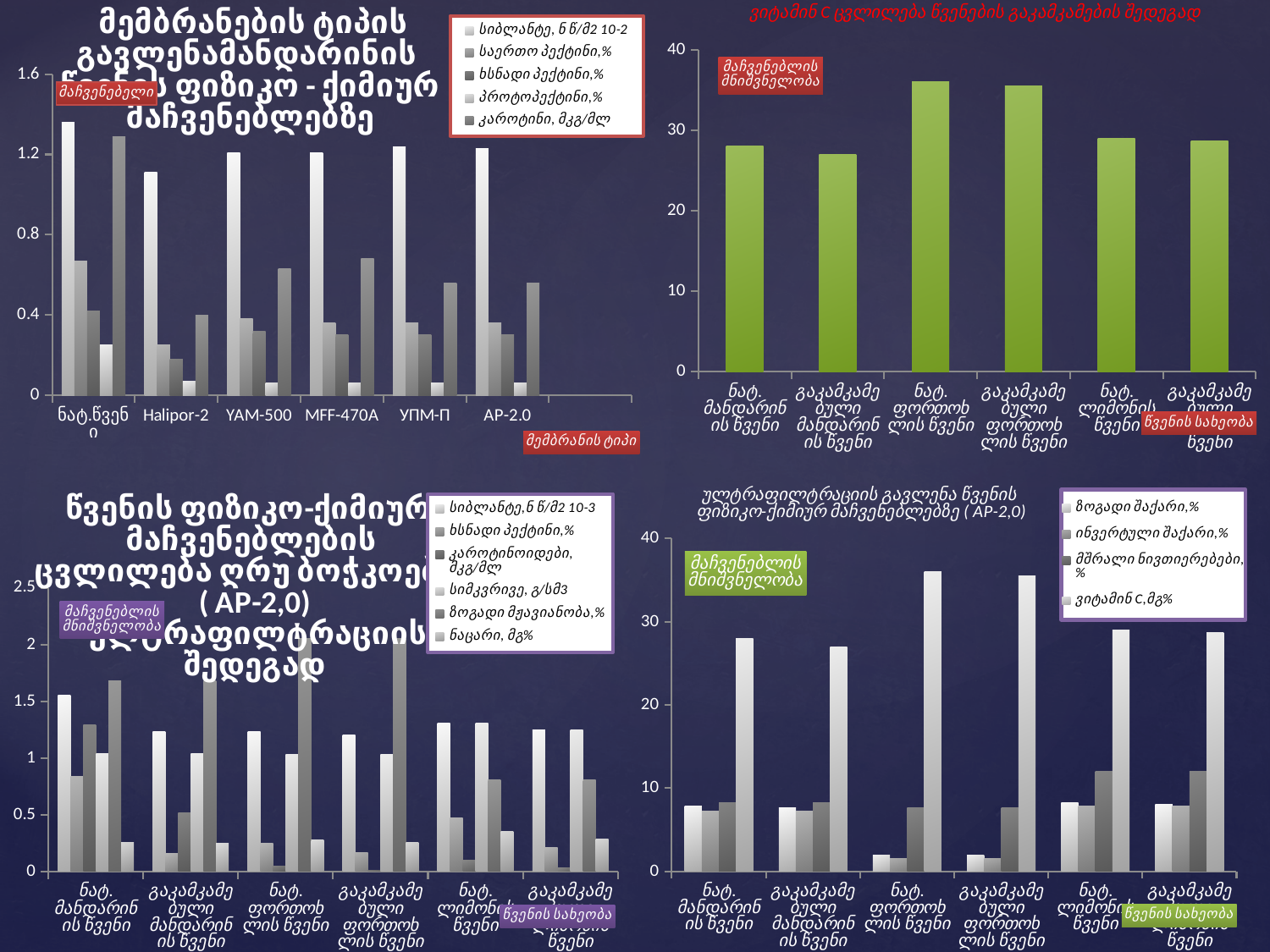
In the top-right chart (ვიტამინ C ცვლილება წვენების გაკამკამების შედეგად), is the value for ნატ. ფორთოხლის წვენი greater or less than 30? greater In the top-right chart (ვიტამინ C ცვლილება წვენების გაკამკამების შედეგად), which is larger: the value for ნატ. ფორთოხლის წვენი or the value for ნატ. მანდარინის წვენი? ნატ. ფორთოხლის წვენი What kind of chart is the top-right chart (ვიტამინ C ცვლილება წვენების გაკამკამების შედეგად)? bar chart In the bottom-right chart, is the value of ვიტამინ C for ნატ. ფორთოხლის წვენი greater or less than 30? greater How many categories are shown on the x axis of the top-right chart (ვიტამინ C ცვლილება წვენების გაკამკამების შედეგად)? 6 How many series does the legend of the bottom-left chart list? 6 What colour are the bars in the top-right chart (ვიტამინ C ცვლილება წვენების გაკამკამების შედეგად)? green How many series does the legend of the bottom-right chart list? 4 In the top-left chart, is the value of სიბლანტე for ნატ.წვენი greater or less than 1.2? greater How many categories are shown on the x axis of the top-left chart? 6 How many series does the legend of the top-left chart list? 5